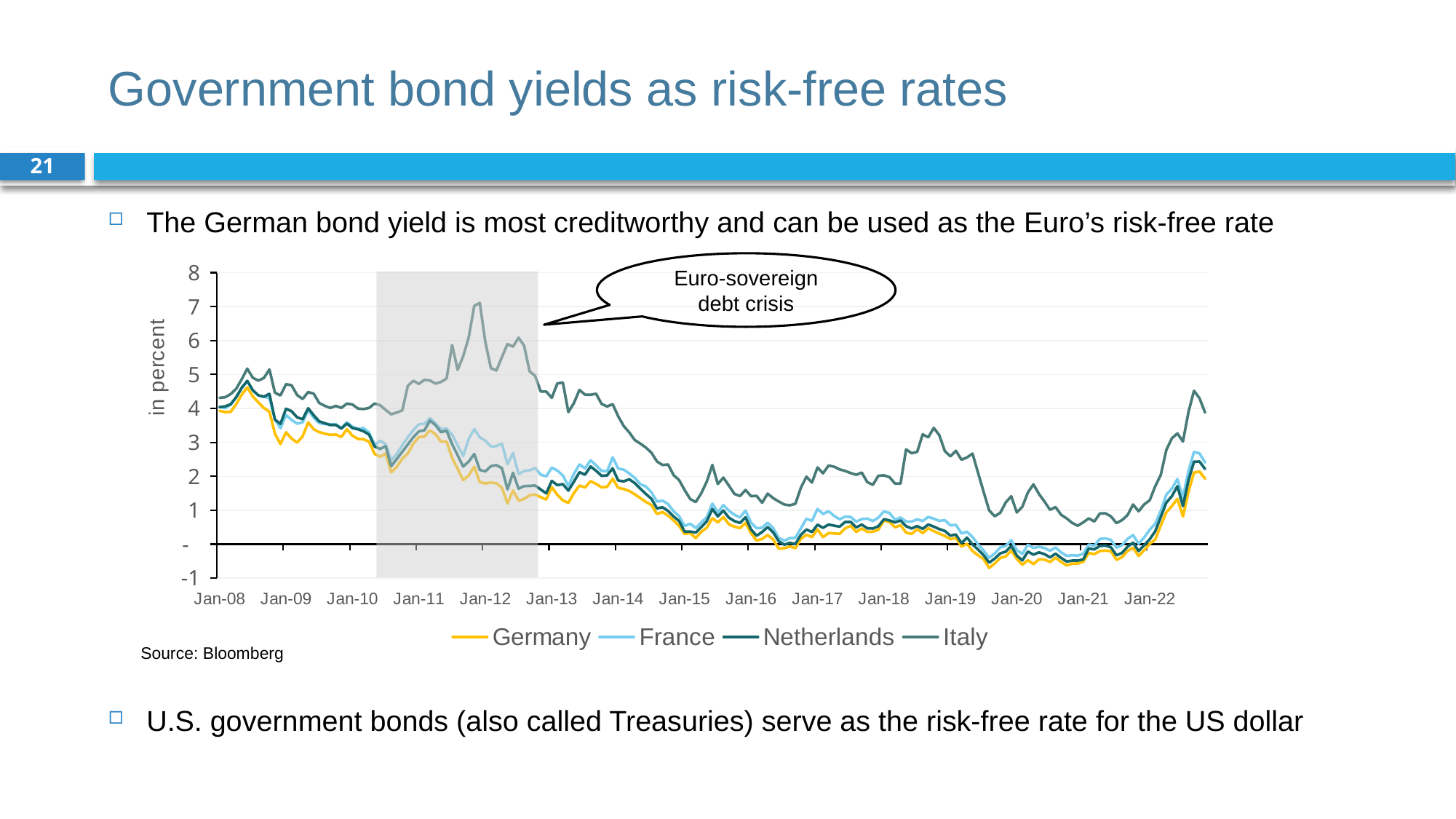
How many series does the legend list? 4 Which countries are listed in the chart legend? Germany, France, Netherlands, Italy How many year labels are shown on the x axis? 15 Is the peak value for Italy around 2012 greater or less than 6? greater Is the value for Germany at Jan-20 greater or less than 1? less Does the Germany series rise or fall overall from Jan-08 to Jan-20? fall Is the value for Italy at Jan-08 greater or less than 4? greater Which series reaches the highest value on the chart? Italy Around Jan-12, which is larger, the value for Italy or the value for Germany? Italy What type of chart is shown on the slide? Line chart What is the label on the y axis of the chart? in percent